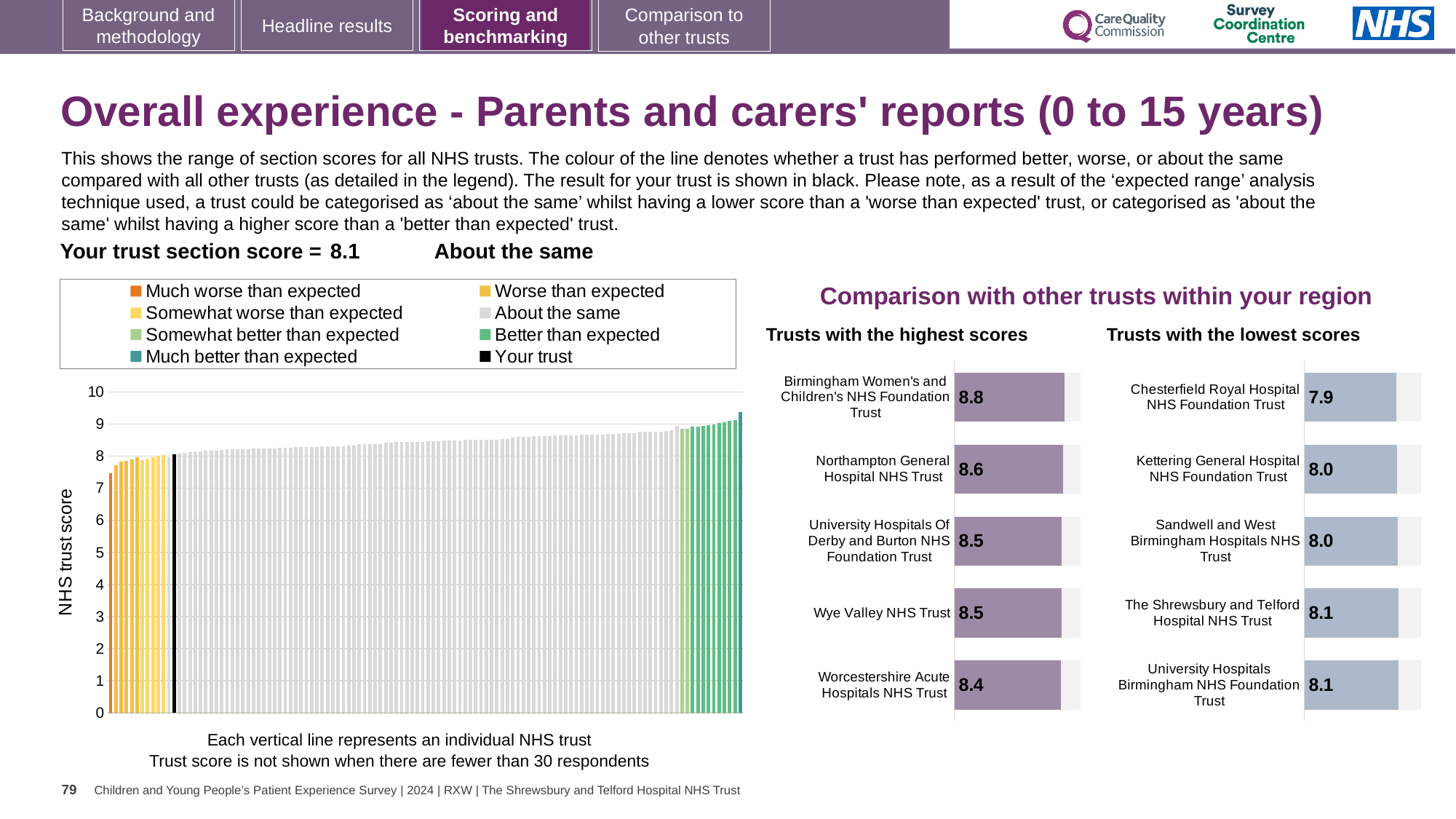
In the 'Trusts with the lowest scores' chart, what is the score for Kettering General Hospital NHS Foundation Trust? 8.0 In the main NHS trust score chart on the left, what is the section score for your trust? 8.1 In the 'Trusts with the highest scores' chart, which trust has the highest score? Birmingham Women's and Children's NHS Foundation Trust In the main NHS trust score chart on the left, do the trust scores rise or fall from left to right? rise In the 'Trusts with the highest scores' chart, what is the difference between the scores of Birmingham Women's and Children's NHS Foundation Trust and Worcestershire Acute Hospitals NHS Trust? 0.4 How many entries does the legend of the main NHS trust score chart on the left list? 8 In the 'Trusts with the lowest scores' chart, what is the score for Chesterfield Royal Hospital NHS Foundation Trust? 7.9 In the 'Trusts with the lowest scores' chart, which has the larger score: The Shrewsbury and Telford Hospital NHS Trust or Chesterfield Royal Hospital NHS Foundation Trust? The Shrewsbury and Telford Hospital NHS Trust How many trusts are listed in the 'Trusts with the highest scores' chart? 5 In the 'Trusts with the highest scores' chart, what is the score for Worcestershire Acute Hospitals NHS Trust? 8.4 In the 'Trusts with the lowest scores' chart, which trust has the lowest score? Chesterfield Royal Hospital NHS Foundation Trust In the 'Trusts with the highest scores' chart, what is the score for Birmingham Women's and Children's NHS Foundation Trust? 8.8